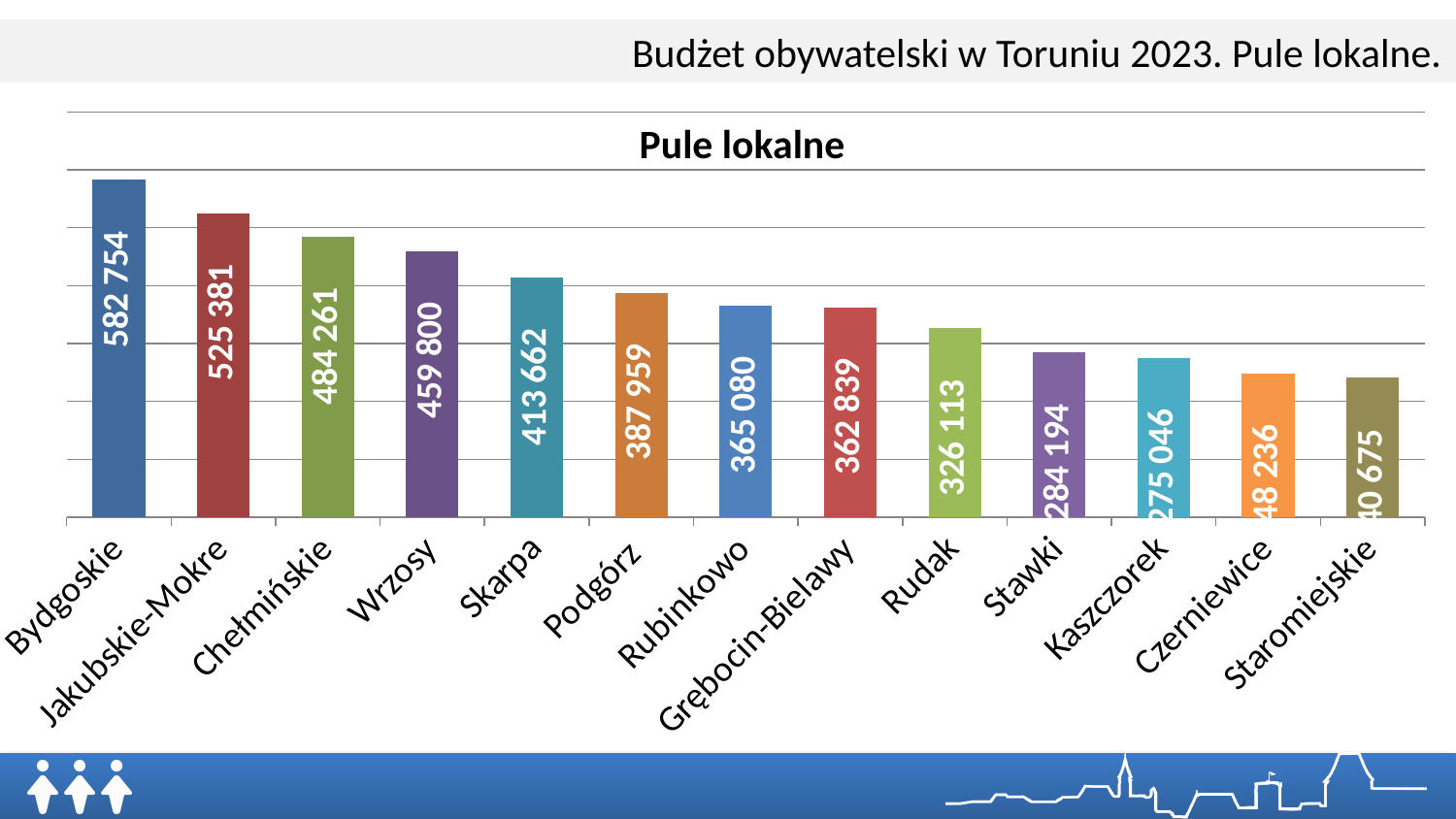
What is the value for Skarpa? 413 662 What is the difference between the values for Bydgoskie and Jakubskie-Mokre? 57 373 What is the value for Rudak? 326 113 What is the difference between the values for Wrzosy and Skarpa? 46 138 What is the value for Kaszczorek? 275 046 Which category has the highest value? Bydgoskie Which category has the lowest value? Staromiejskie What is the title of the chart? Pule lokalne What kind of chart is shown on the slide? Bar chart How many categories are shown in the chart? 13 What is the value for Bydgoskie? 582 754 Which is larger, the value for Podgórz or the value for Rudak? Podgórz